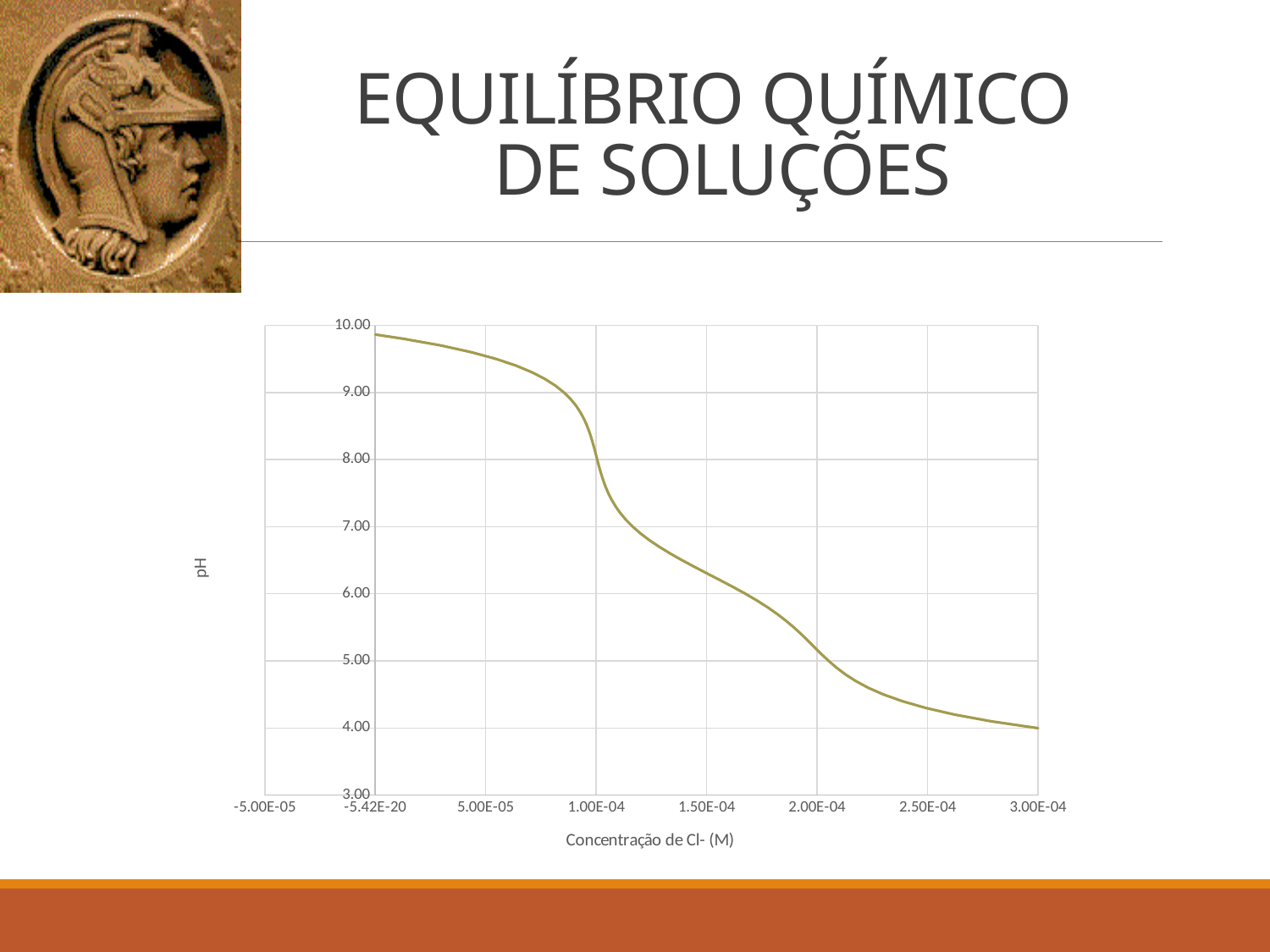
What is the highest value shown on the pH axis? 10.00 What kind of chart is shown on the slide? line chart Is the pH at a Cl- concentration of 1.50E-04 greater or less than 6.00? greater Which of the two has a higher pH: a Cl- concentration of 5.00E-05 or 2.50E-04? 5.00E-05 What is the label of the x axis? Concentração de Cl- (M) Is the pH at a Cl- concentration of 1.50E-04 greater or less than 7.00? less Is the pH at a Cl- concentration of 5.00E-05 greater or less than 9.00? greater What is the label of the y axis? pH Does the pH rise or fall as the concentration of Cl- increases along the x axis? fall